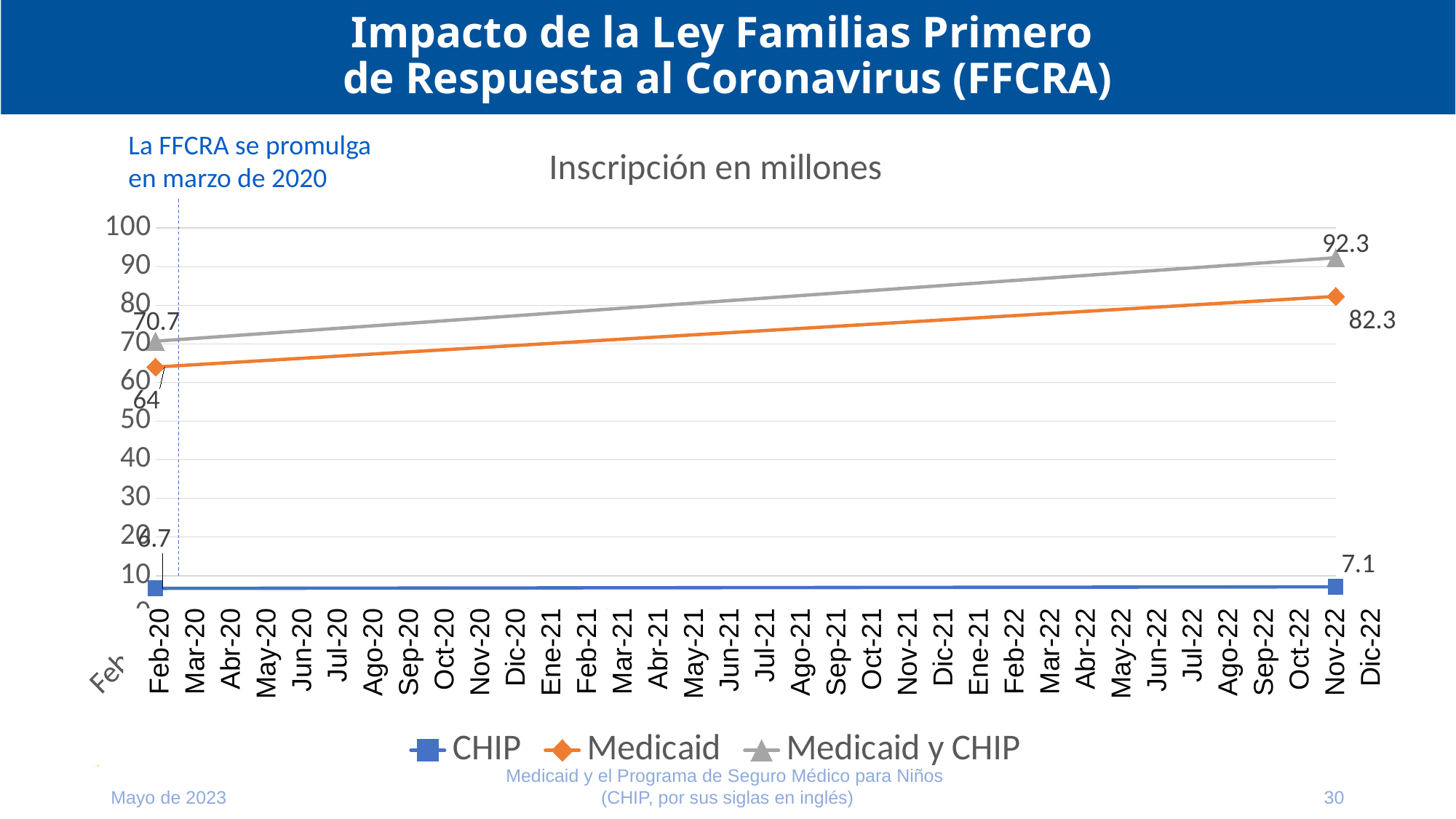
What is the value for Medicaid y CHIP in Feb-20? 70.7 How many series does the legend list? 3 Does the Medicaid y CHIP line rise or fall from Feb-20 to Nov-22? rise What is the value for CHIP in Nov-22? 7.1 Which series has the lowest value in Feb-20? CHIP What kind of chart is shown on the slide? line chart By how much did the Medicaid value increase from Feb-20 to Nov-22? 18.3 What is the value for Medicaid y CHIP in Nov-22? 92.3 Is the Medicaid value in Nov-22 greater or less than 80? greater Which series has the highest value in Nov-22? Medicaid y CHIP What is the title of the chart? Inscripción en millones What is the value for Medicaid in Feb-20? 64